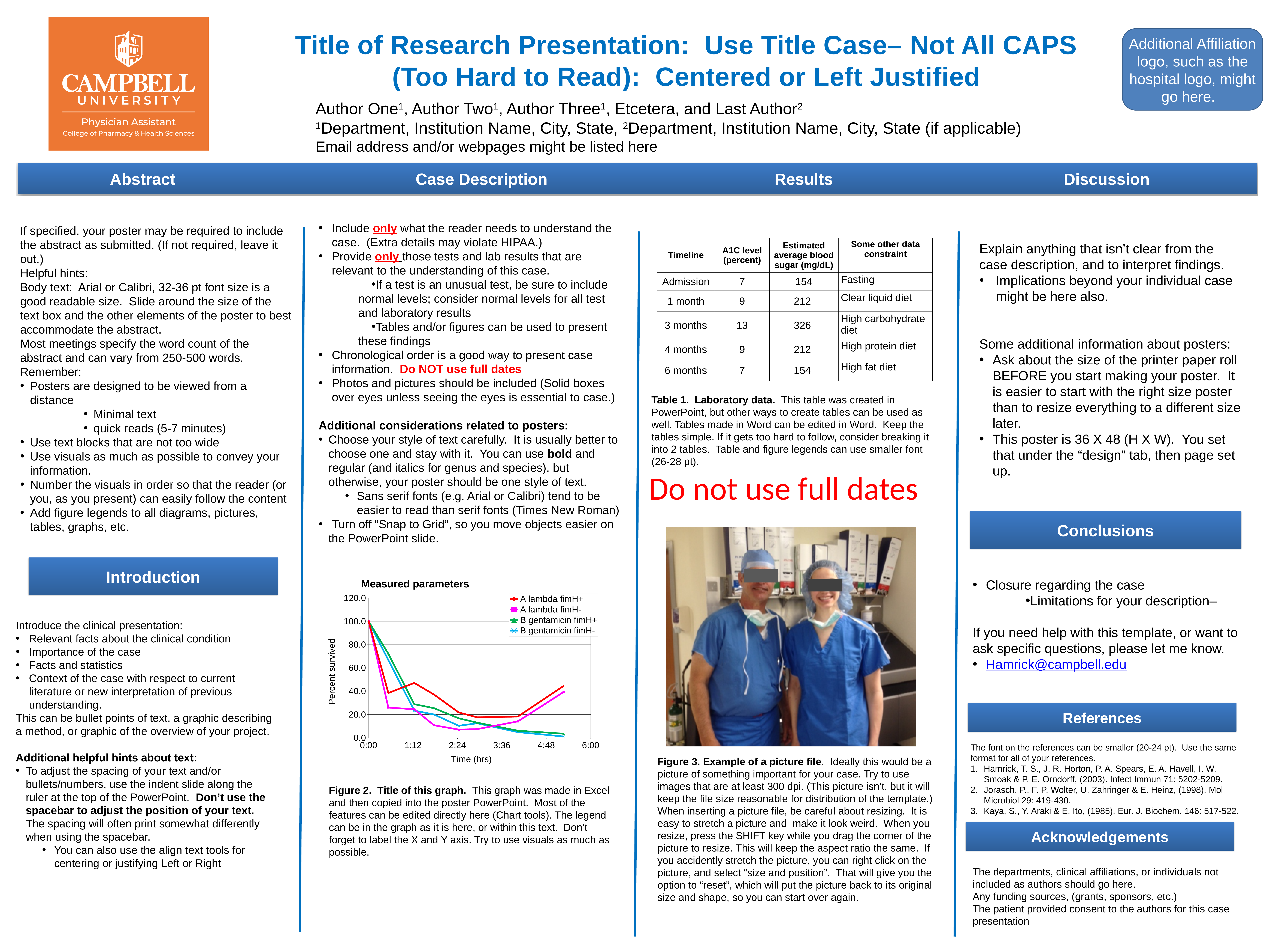
In the "Measured parameters" chart, which series has the higher value at the last time point: A lambda fimH+ or B gentamicin fimH+? A lambda fimH+ In the "Measured parameters" chart, what is the value for A lambda fimH+ at time 0:00? 100.0 How many series does the legend of the "Measured parameters" chart list? 4 What is the label of the y axis on the "Measured parameters" chart? Percent survived What kind of chart is the "Measured parameters" chart? line chart In the "Measured parameters" chart, is the value for A lambda fimH+ at 1:12 greater or less than 60? less In the "Measured parameters" chart, which is larger at 1:12: A lambda fimH+ or A lambda fimH-? A lambda fimH+ In the "Measured parameters" chart, is the value for A lambda fimH- at 1:12 greater or less than 40? less What is the title of the line chart on the slide? Measured parameters In the "Measured parameters" chart, is the final value for B gentamicin fimH+ greater or less than 20? less What is the highest tick value shown on the y axis of the "Measured parameters" chart? 120.0 In the "Measured parameters" chart, does the B gentamicin fimH- series rise or fall overall along the x axis? fall